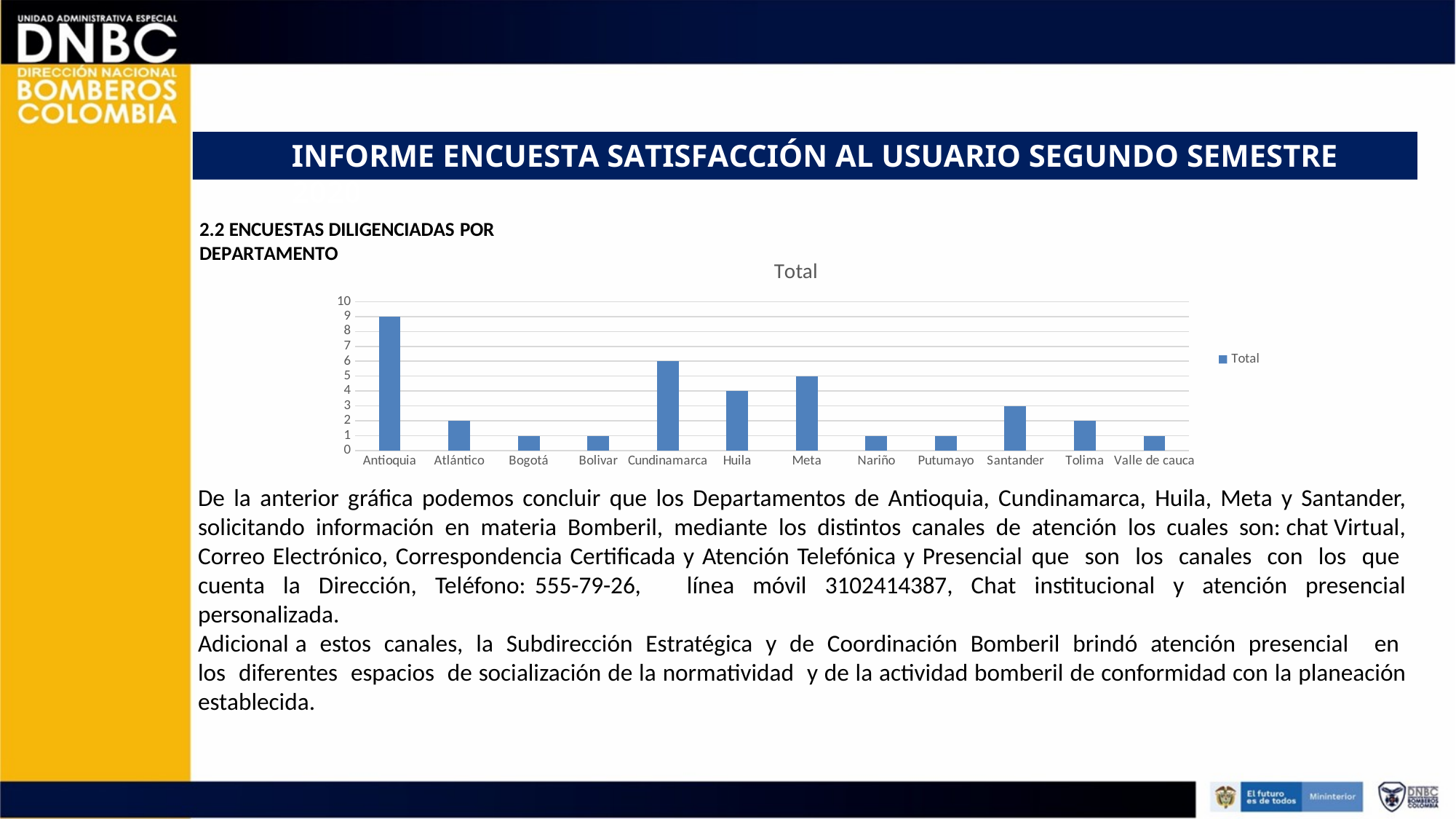
What is the value for Meta? 5 What is the value for Cundinamarca? 6 Which is larger, the value for Santander or the value for Tolima? Santander Is the value for Antioquia greater or less than 8? greater What is the title of the chart? Total How many departments are shown on the x axis of the chart? 12 What is the value for Huila? 4 What is the difference between the values for Antioquia and Cundinamarca? 3 Which department has the highest value in the chart? Antioquia What is the value for Antioquia? 9 What type of chart is shown on the slide? bar chart How many series does the legend list? 1